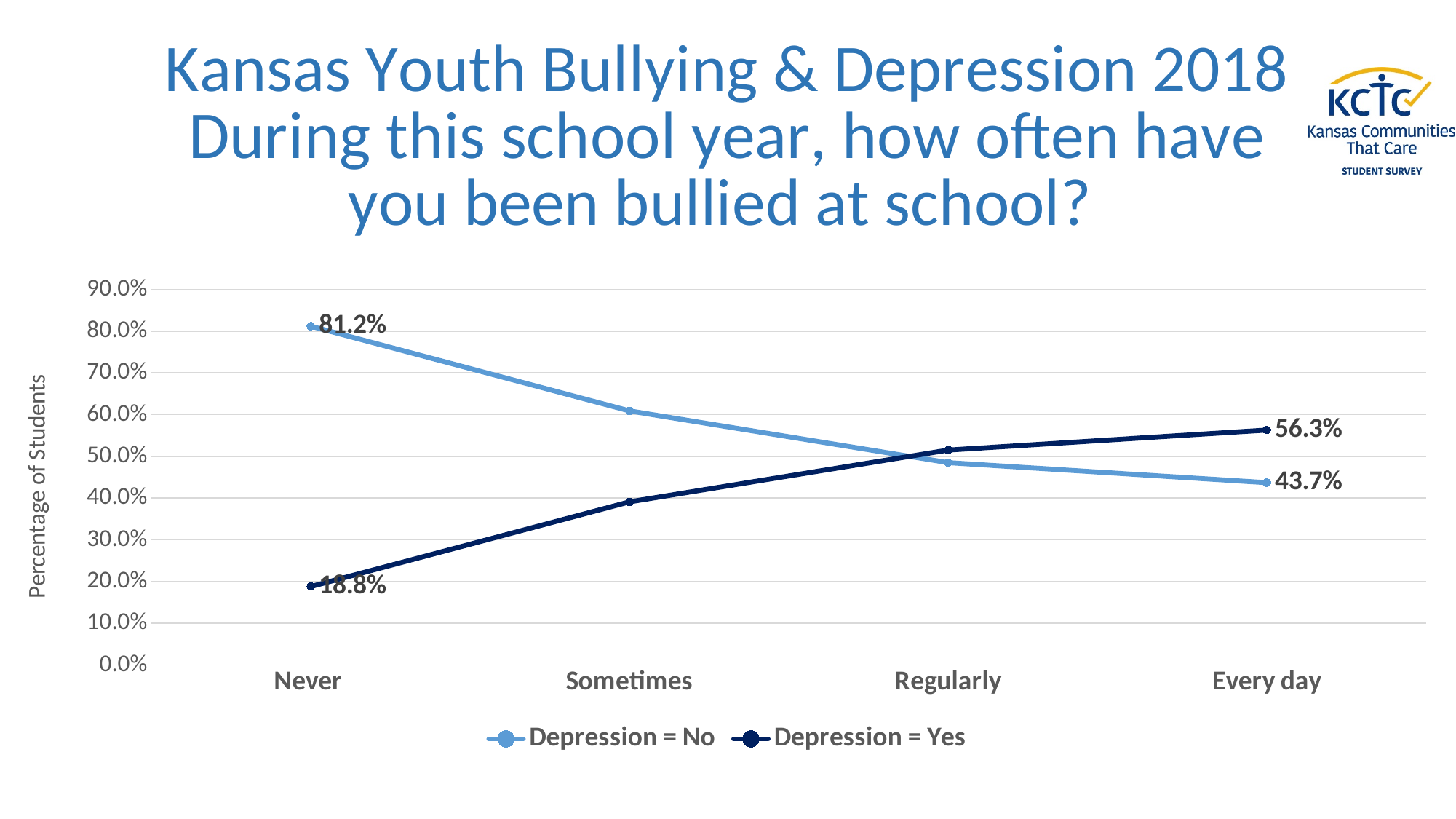
Is the value for Depression = No at Sometimes greater or less than 50.0%? greater What is the value for Depression = No at Every day? 43.7% How many series does the legend list? 2 How many categories are shown on the x axis? 4 At Every day, how much higher is Depression = Yes than Depression = No? 12.6 percentage points At Every day, which series has the larger value, Depression = No or Depression = Yes? Depression = Yes Does the Depression = No line rise or fall from Never to Every day? fall What is the value for Depression = Yes at Never? 18.8% At Never, how much higher is Depression = No than Depression = Yes? 62.4 percentage points Is the value for Depression = Yes at Sometimes greater or less than 30.0%? greater What is the value for Depression = No at Never? 81.2% What is the value for Depression = Yes at Every day? 56.3%